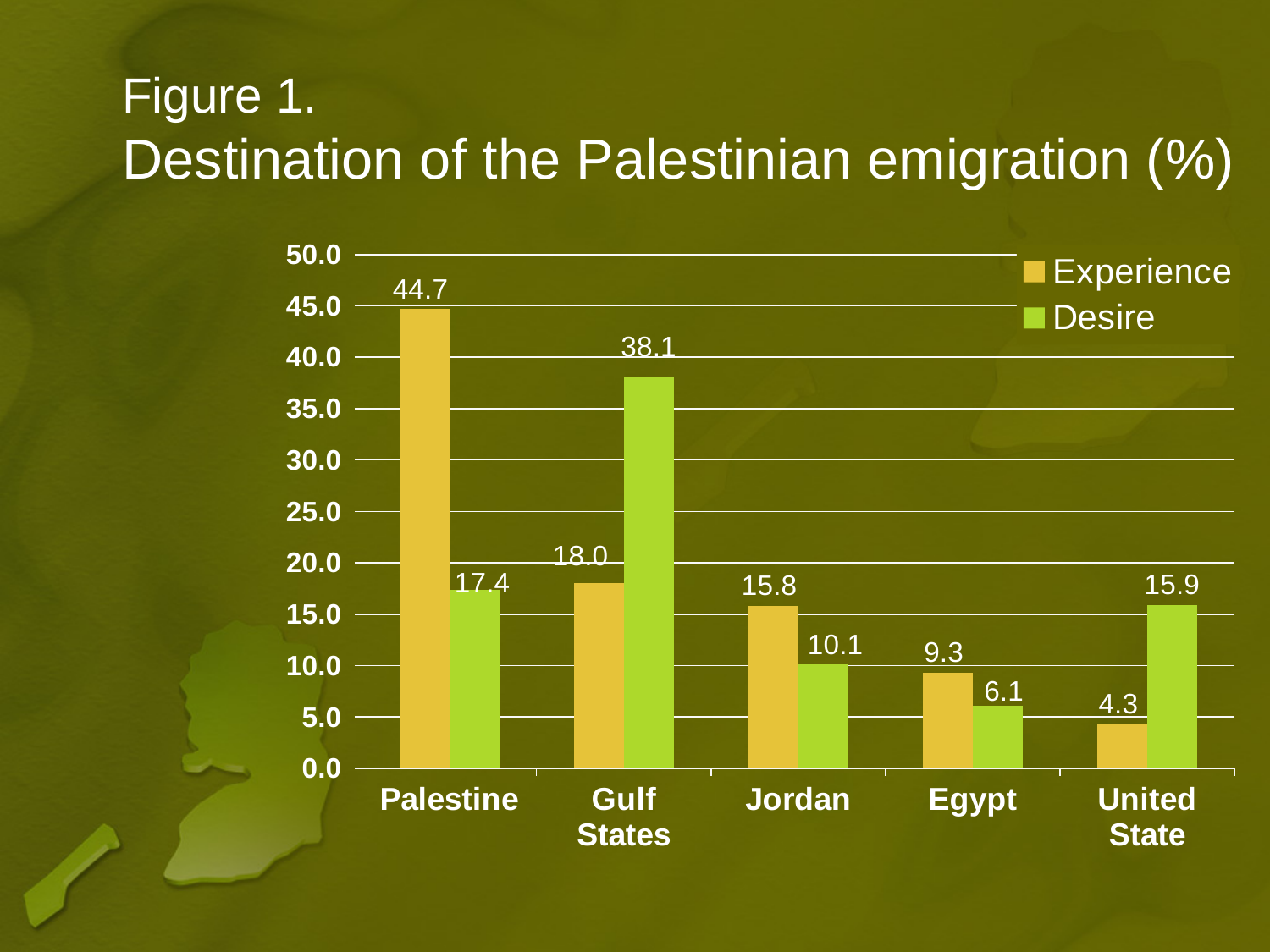
Which destination has the highest Experience value? Palestine What colour are the Desire bars? green Which destination has the lowest Desire value? Egypt What is the difference between the Experience and Desire values for Palestine? 27.3 How many destination categories are shown on the x axis? 5 What kind of chart is shown on the slide? bar chart What is the Desire value for Gulf States? 38.1 Is the Desire value for Gulf States greater or less than 35.0? greater Which is larger for Jordan, the Experience value or the Desire value? Experience What is the Experience value for Palestine? 44.7 What is the Desire value for United State? 15.9 How many series does the legend list? 2